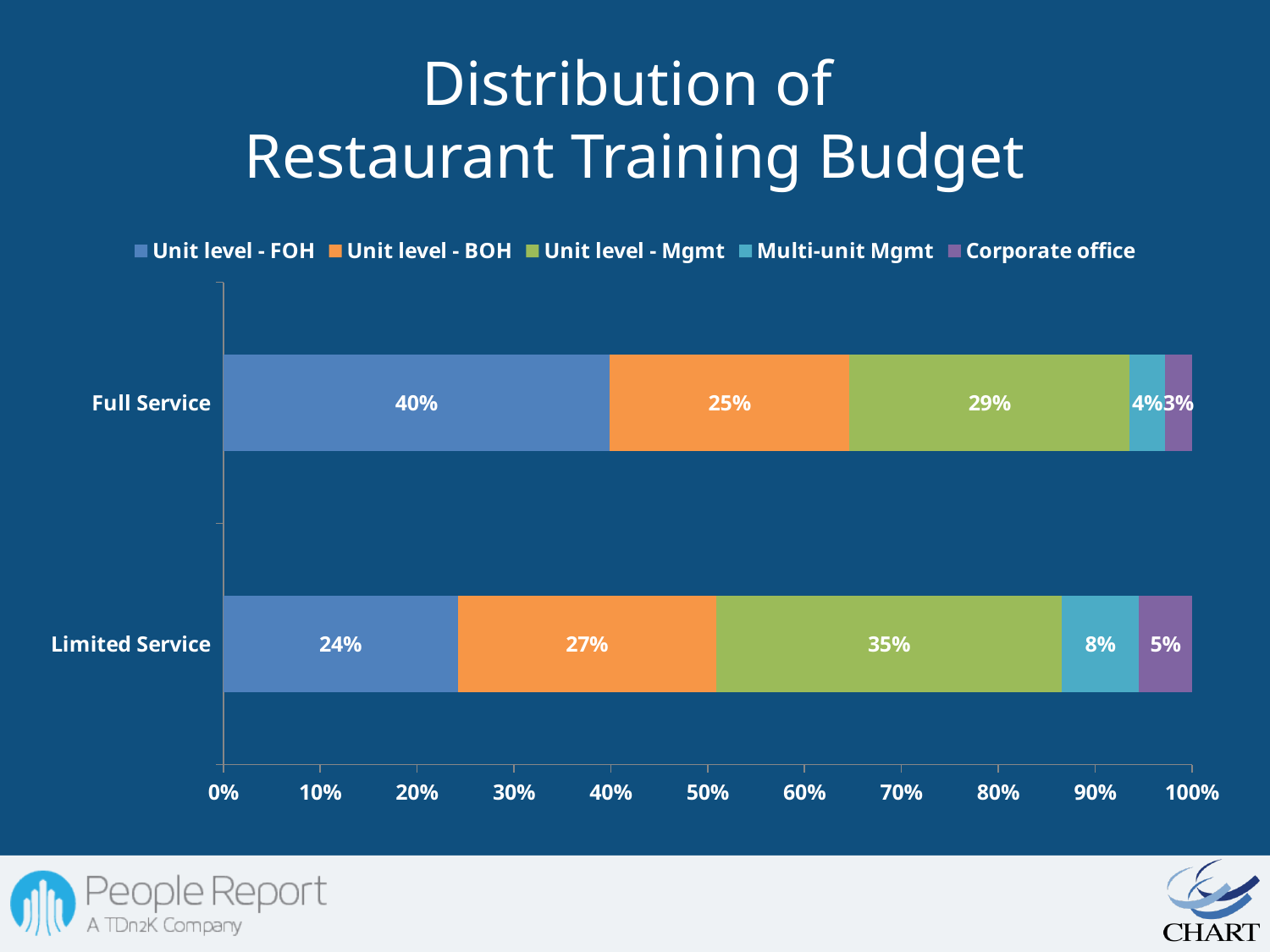
Which has a larger Unit level - BOH share, Full Service or Limited Service? Limited Service What is the title of the chart? Distribution of Restaurant Training Budget Which segment is the smallest in the Limited Service bar? Corporate office What kind of chart is shown on the slide? Stacked bar chart What share of the training budget goes to Unit level - FOH for Full Service? 40% Which segment is the largest in the Full Service bar? Unit level - FOH How many categories are shown on the chart? 2 What is the Multi-unit Mgmt value for Full Service? 4% What is the difference between the Unit level - FOH values for Full Service and Limited Service? 16% What share of the training budget goes to Unit level - Mgmt for Limited Service? 35% How many series does the legend list? 5 What is the Corporate office value for Limited Service? 5%